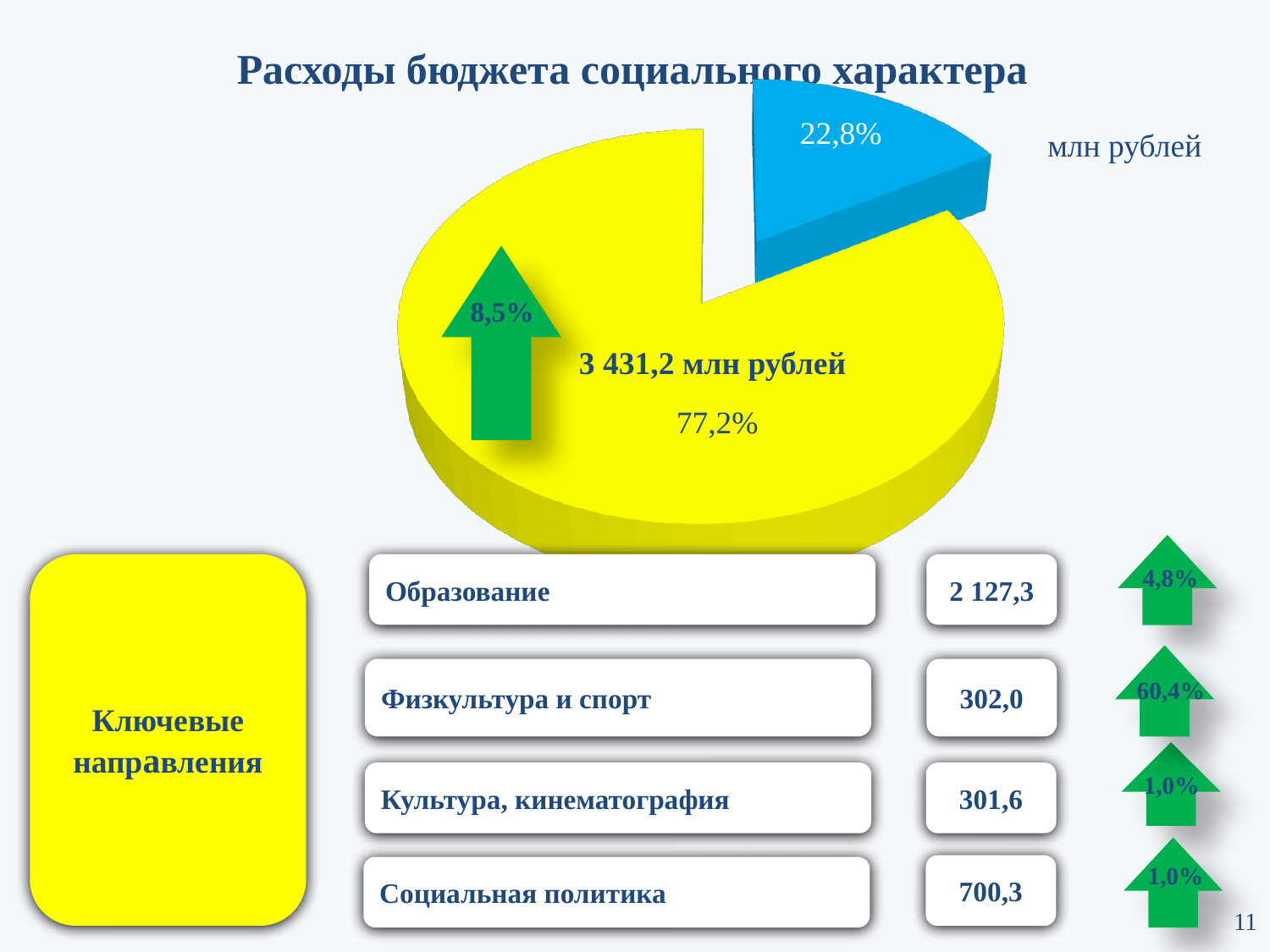
What share of the pie does the blue slice represent? 22,8% What kind of chart is shown on the slide? pie chart How many slices does the pie chart have? 2 Which slice of the pie chart is larger, the yellow one or the blue one? the yellow one Which slice of the pie chart is the smallest? the blue slice (22,8%) What share of the pie does the yellow slice represent? 77,2% What unit is indicated next to the pie chart? млн рублей What is the title of the chart on the slide? Расходы бюджета социального характера What is the difference in percentage points between the yellow slice and the blue slice of the pie chart? 54,4 What value in million rubles is printed on the yellow slice of the pie chart? 3 431,2 млн рублей